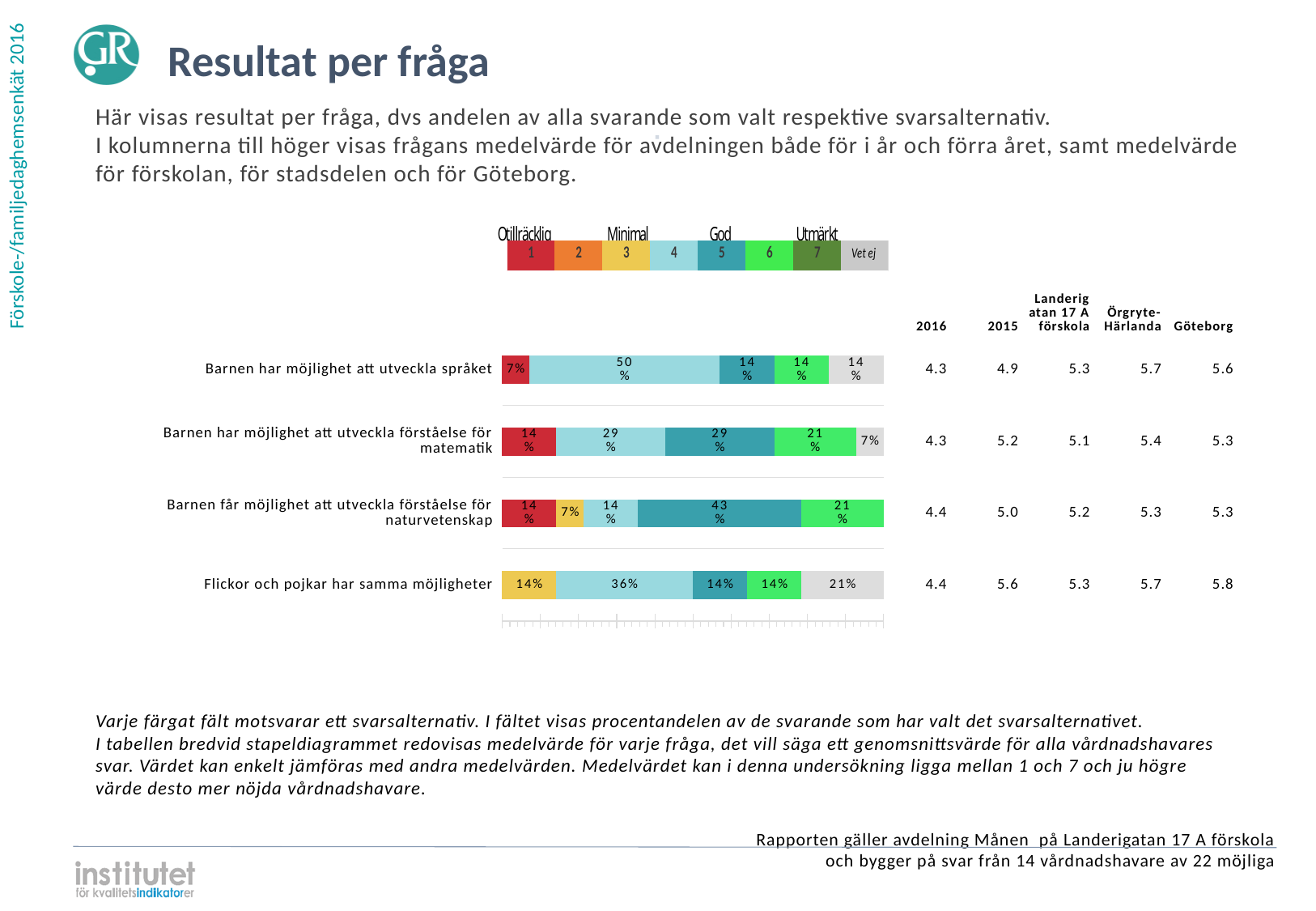
How many questions (categories) are plotted as bars in the chart? 4 What kind of chart is shown on the slide? Stacked horizontal bar chart How many percentage points larger is the alternative 4 (light blue) share for 'Barnen har möjlighet att utveckla språket' than for 'Barnen har möjlighet att utveckla förståelse för matematik'? 21 percentage points What is the 2016 mean value shown for 'Barnen har möjlighet att utveckla språket'? 4.3 What percentage of respondents chose alternative 4 (light blue) for 'Barnen har möjlighet att utveckla språket'? 50% What label does the legend give to alternatives 5 and 6? God How many response alternatives does the legend above the chart list? 8 What percentage chose 'Vet ej' for 'Flickor och pojkar har samma möjligheter'? 21% Which question has the largest share for alternative 5 (teal)? Barnen får möjlighet att utveckla förståelse för naturvetenskap What percentage chose alternative 1 (red) for 'Barnen har möjlighet att utveckla språket'? 7% What percentage chose alternative 5 (teal) for 'Barnen får möjlighet att utveckla förståelse för naturvetenskap'? 43% For 'Barnen har möjlighet att utveckla förståelse för matematik', which is larger: the share for alternative 1 (red) or the share for 'Vet ej'? Alternative 1 (14%)